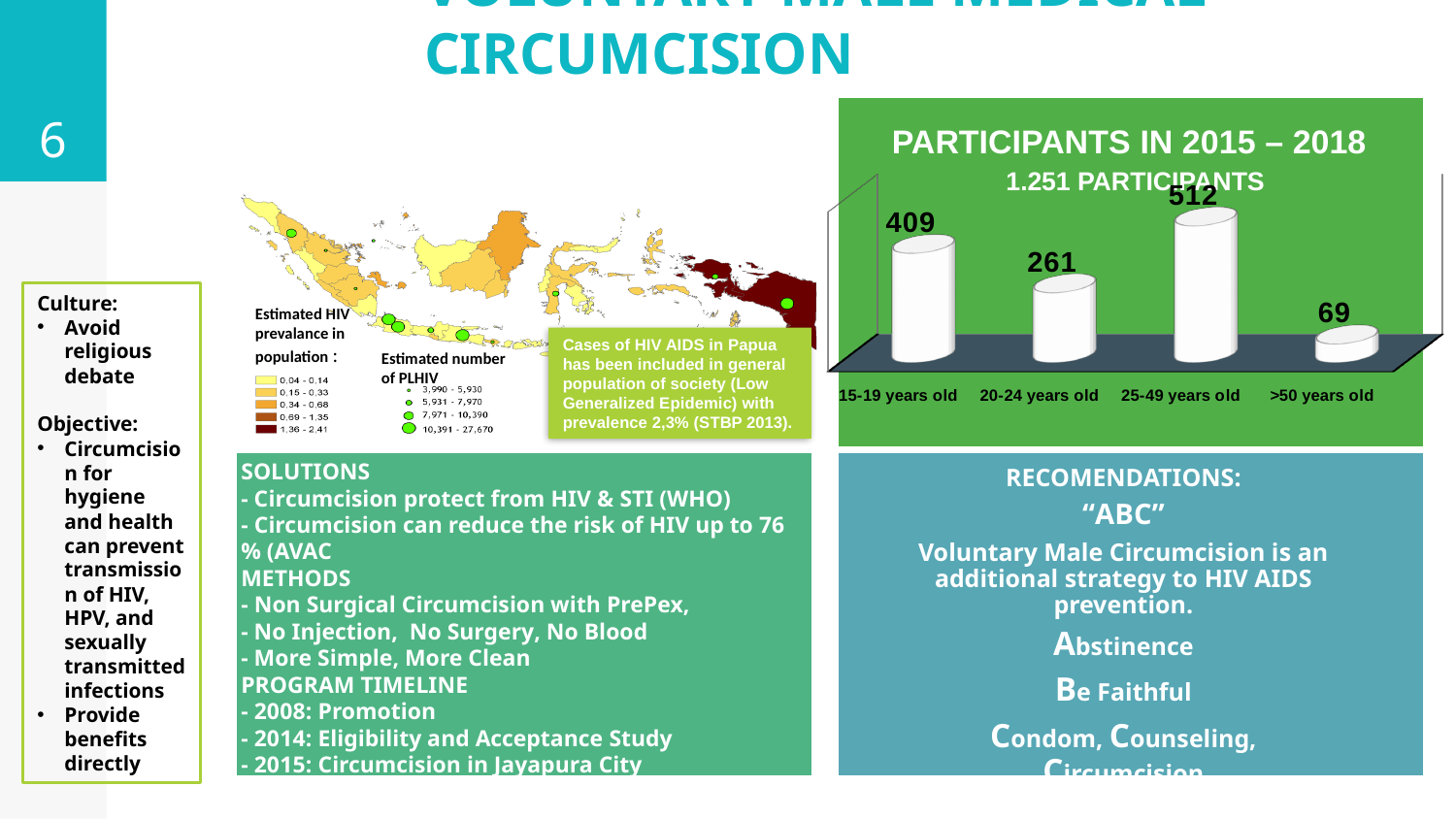
What is the difference in participants between the 25-49 years old group and the 15-19 years old group? 103 What is the value for the 20-24 years old group in the participants chart? 261 What is the title of the chart on the slide? PARTICIPANTS IN 2015 – 2018 What is the value for the 25-49 years old group in the participants chart? 512 Which age group has the lowest number of participants? >50 years old Which age group has the highest number of participants? 25-49 years old What kind of chart is used to show participants in 2015 – 2018? Bar chart Which group has more participants, 15-19 years old or 20-24 years old? 15-19 years old What is the difference in participants between the 20-24 years old group and the >50 years old group? 192 How many age groups are shown in the participants chart? 4 What is the value for the 15-19 years old group in the participants chart? 409 What is the value for the >50 years old group in the participants chart? 69